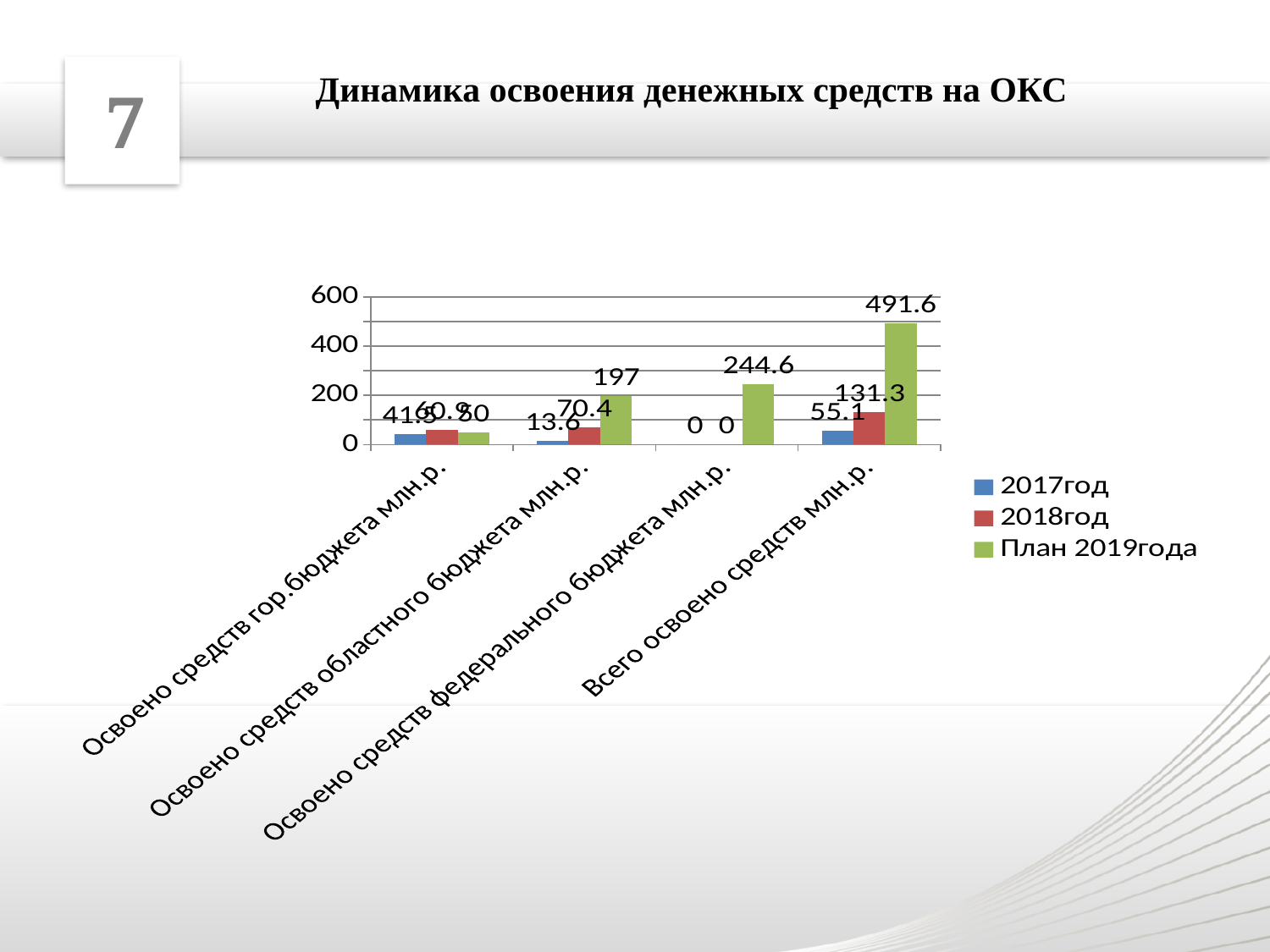
What is the value of 2017год for Освоено средств областного бюджета млн.р.? 13.6 How many categories are shown on the x axis? 4 What is the value of План 2019года for Всего освоено средств млн.р.? 491.6 What is the value of 2018год for Освоено средств областного бюджета млн.р.? 70.4 What is the value of 2017год for Освоено средств федерального бюджета млн.р.? 0 How many series does the legend list? 3 What kind of chart is shown on the slide? bar chart What is the difference between the 2018год and 2017год values for Всего освоено средств млн.р.? 76.2 Which category has the highest value for План 2019года? Всего освоено средств млн.р. What is the title of the chart? Динамика освоения денежных средств на ОКС What is the value of План 2019года for Освоено средств федерального бюджета млн.р.? 244.6 Which is larger for План 2019года: Освоено средств областного бюджета млн.р. or Освоено средств федерального бюджета млн.р.? Освоено средств федерального бюджета млн.р.